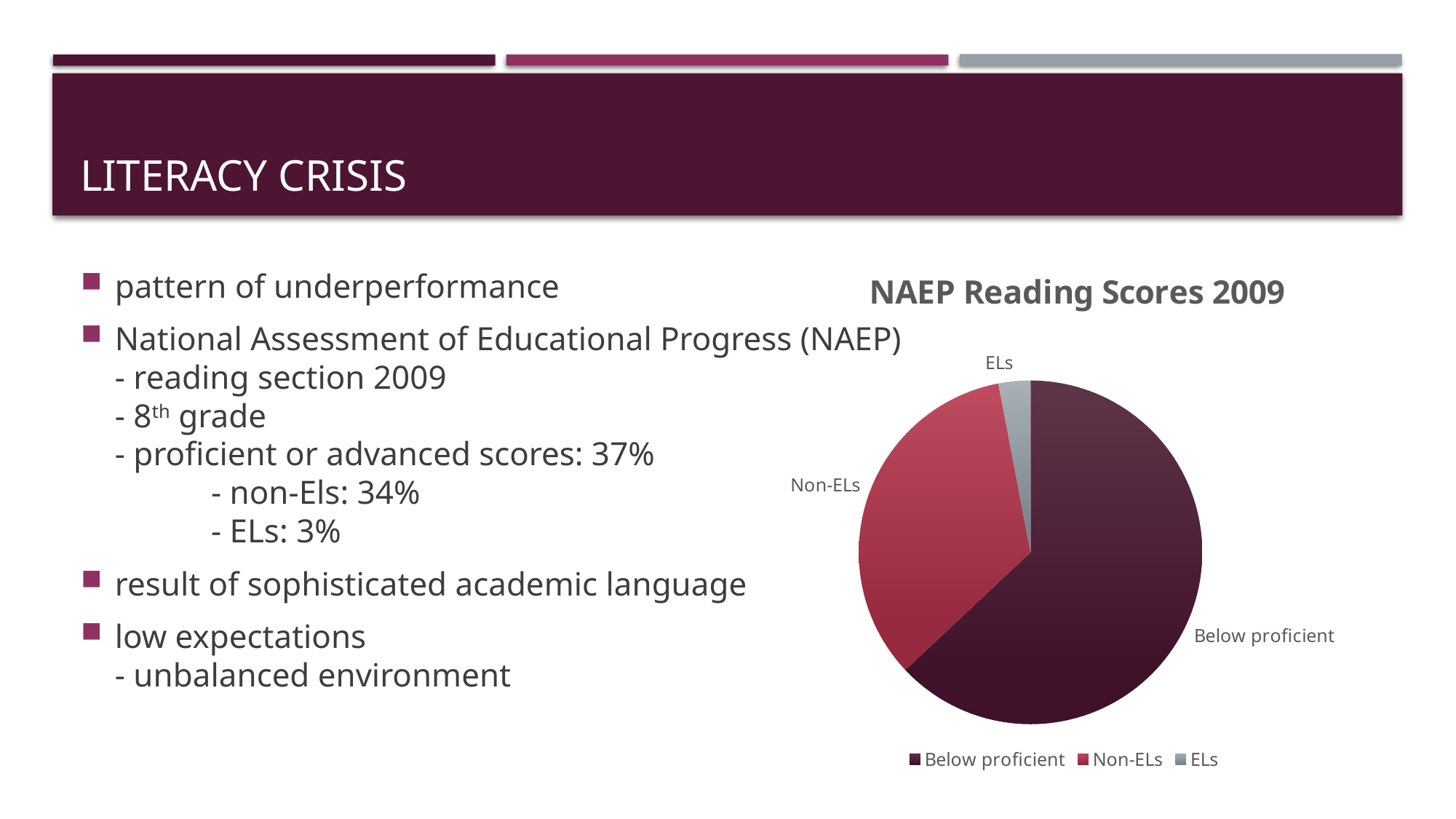
Which category has the largest slice of the pie? Below proficient Which category is shown in grey in the pie chart? ELs What is the title of the chart? NAEP Reading Scores 2009 Which slice is larger, Below proficient or Non-ELs? Below proficient Which slice is larger, Non-ELs or ELs? Non-ELs How many slices does the pie chart have? 3 What kind of chart is shown on the slide? pie chart How many entries does the chart legend list? 3 Which category has the smallest slice of the pie? ELs